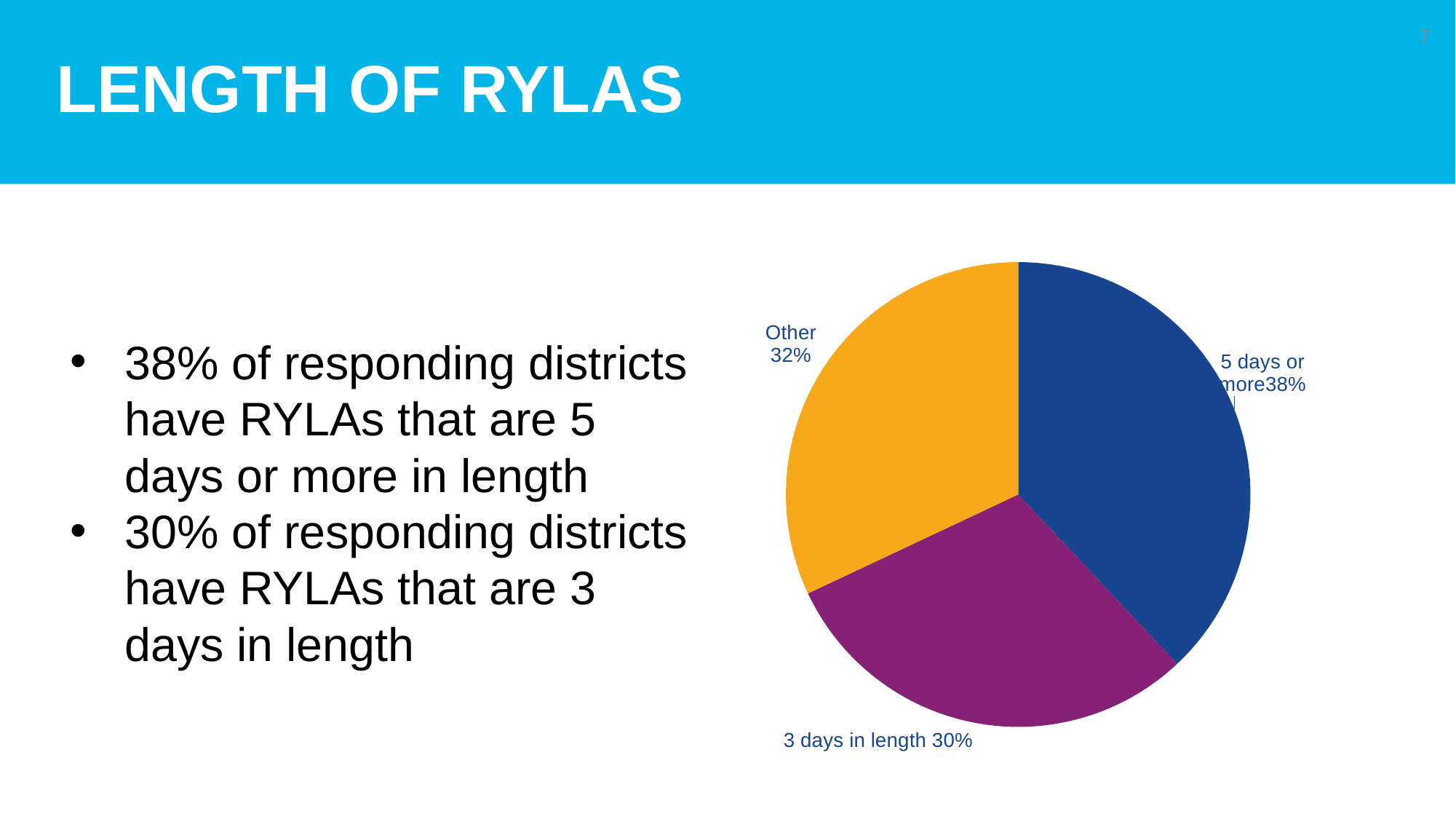
What share of the pie is labelled "3 days in length"? 30% What is the difference in percentage points between the "Other" slice and the "3 days in length" slice? 2 Which is larger, the "Other" slice or the "3 days in length" slice? Other What share of the pie is labelled "Other"? 32% What kind of chart is shown on the slide? pie chart What share of the pie is labelled "5 days or more"? 38% What colour is the "3 days in length" slice? purple Which slice of the pie is the largest? 5 days or more What is the difference in percentage points between the "5 days or more" slice and the "3 days in length" slice? 8 Which slice of the pie is the smallest? 3 days in length What colour is the "Other" slice? orange How many slices does the pie chart have? 3